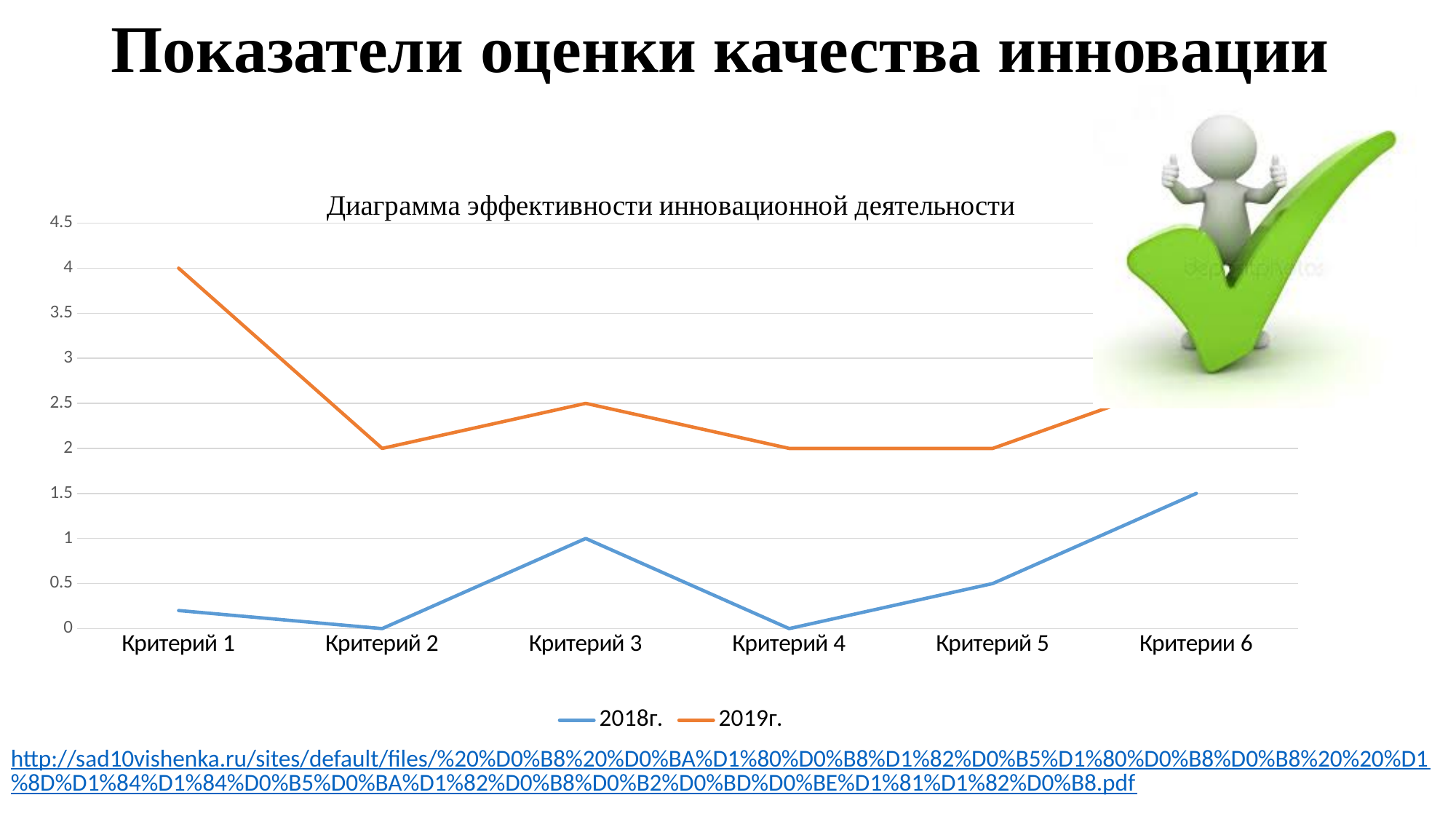
What is the value for 2018г. at Критерий 3? 1 Which category has the highest value for 2018г.? Критерии 6 Which category has the highest value for 2019г.? Критерий 1 How many categories are shown on the x axis? 6 What is the title of the chart? Диаграмма эффективности инновационной деятельности What kind of chart is shown on the slide? line chart Is the value for 2018г. at Критерий 1 greater or less than 0.5? less What is the value for 2018г. at Критерии 6? 1.5 What is the value for 2019г. at Критерий 3? 2.5 What is the difference between the 2019г. and 2018г. values at Критерий 3? 1.5 How many series does the legend list? 2 What is the value for 2019г. at Критерий 1? 4